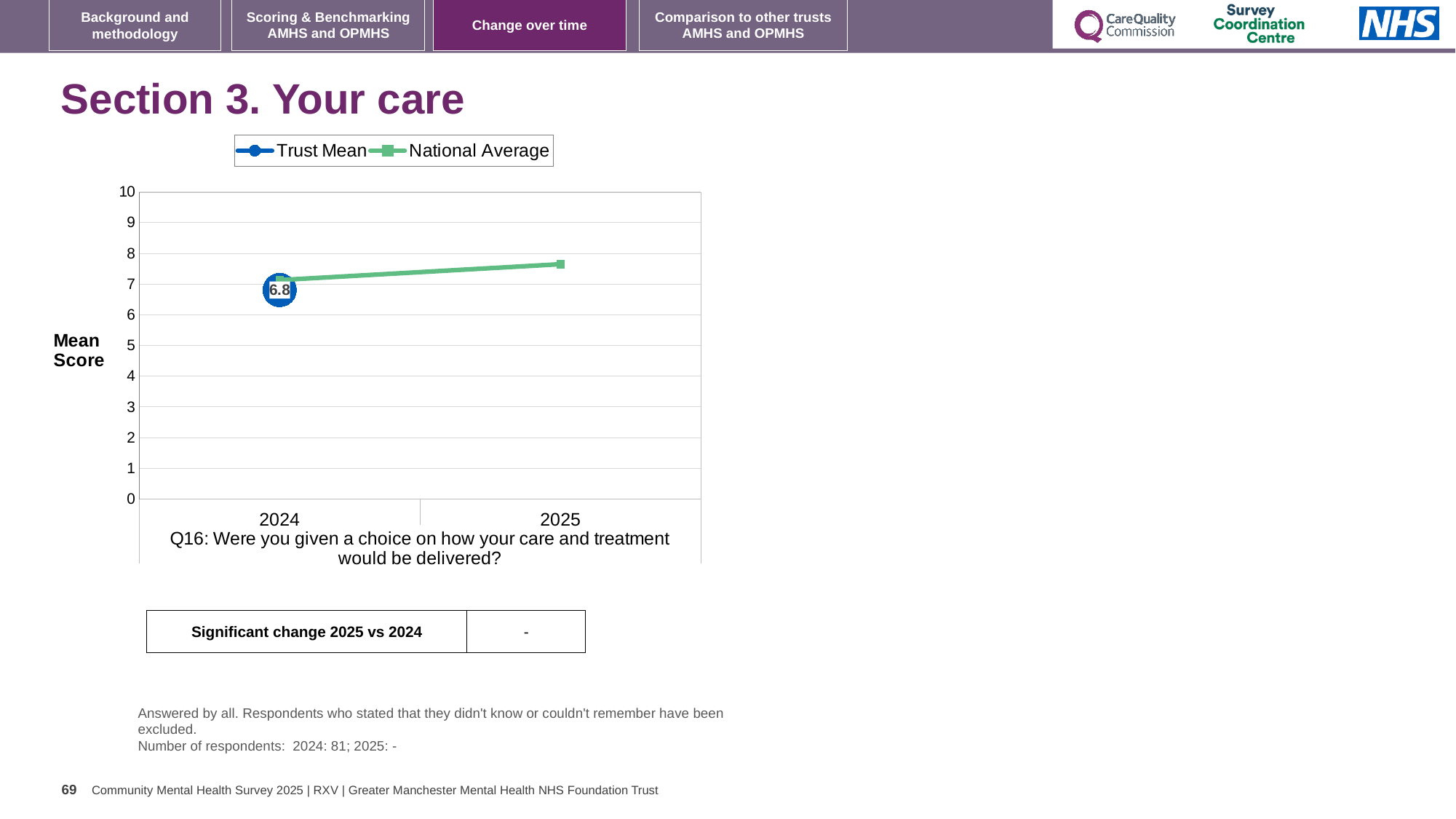
How many series does the legend list? 2 What kind of chart is shown on the slide? line chart Is the Trust Mean value for 2024 greater or less than 5? greater What is the Trust Mean score for 2024? 6.8 In which year is the National Average higher, 2024 or 2025? 2025 What are the two series named in the legend? Trust Mean and National Average How many years are shown on the x axis? 2 What is the label on the y axis? Mean Score Is the National Average value for 2024 greater or less than 5? greater Is the National Average value for 2025 greater or less than 7? greater Which is larger in 2024, the Trust Mean or the National Average? National Average Does the National Average rise or fall from 2024 to 2025? rise